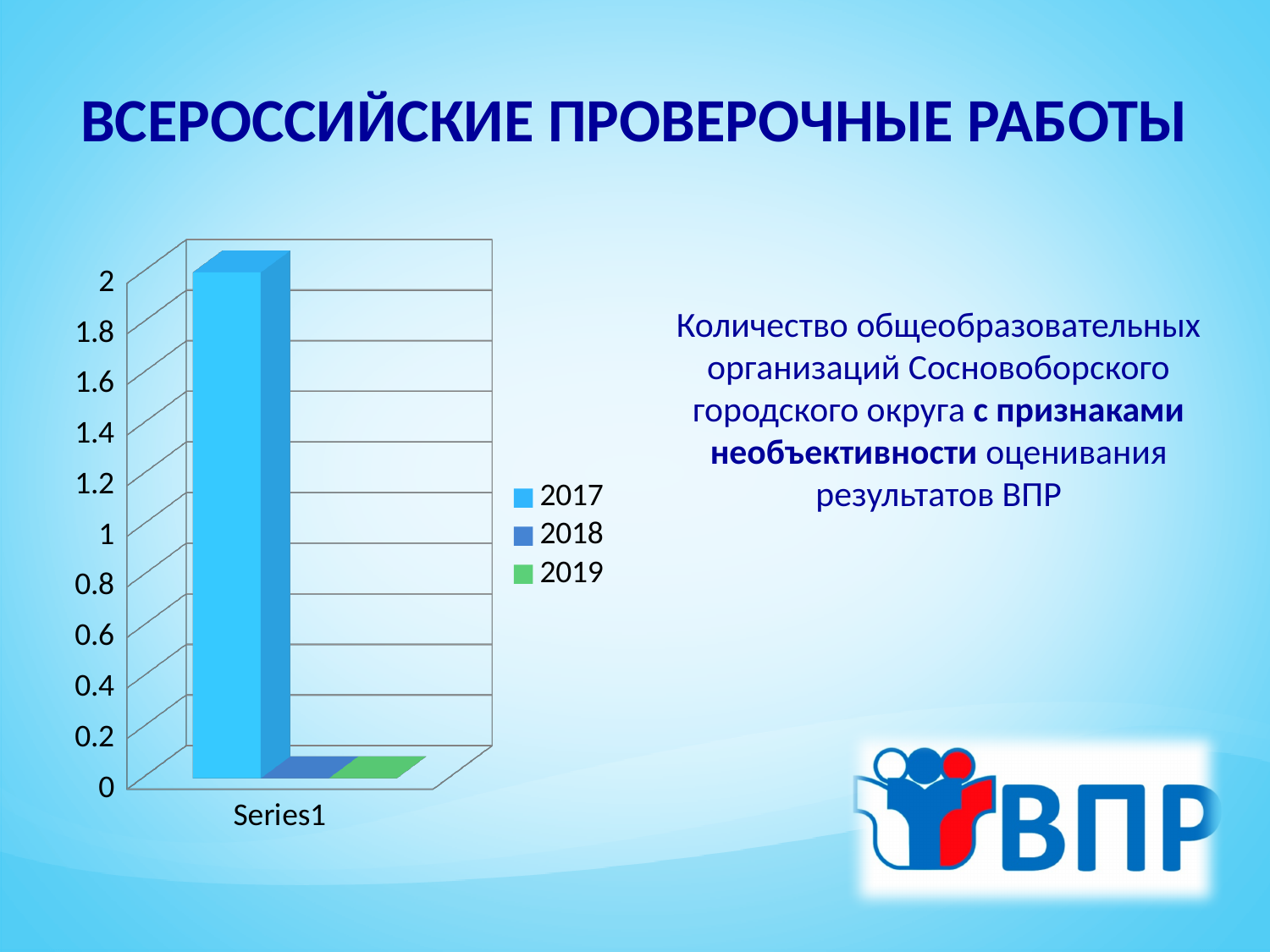
What is the difference between the values for 2017 and 2018? 2 How many categories are shown on the x axis? 1 Which is larger, the value for 2017 or the value for 2019? 2017 How many series does the legend list? 3 What is the label of the category on the x axis? Series1 What colour represents 2019 in the legend? green What is the value for 2019? 0 What is the value for 2018? 0 What is the value for 2017? 2 Is the value for 2017 greater or less than 1? greater What kind of chart is shown on the slide? bar chart Which series has the highest value? 2017